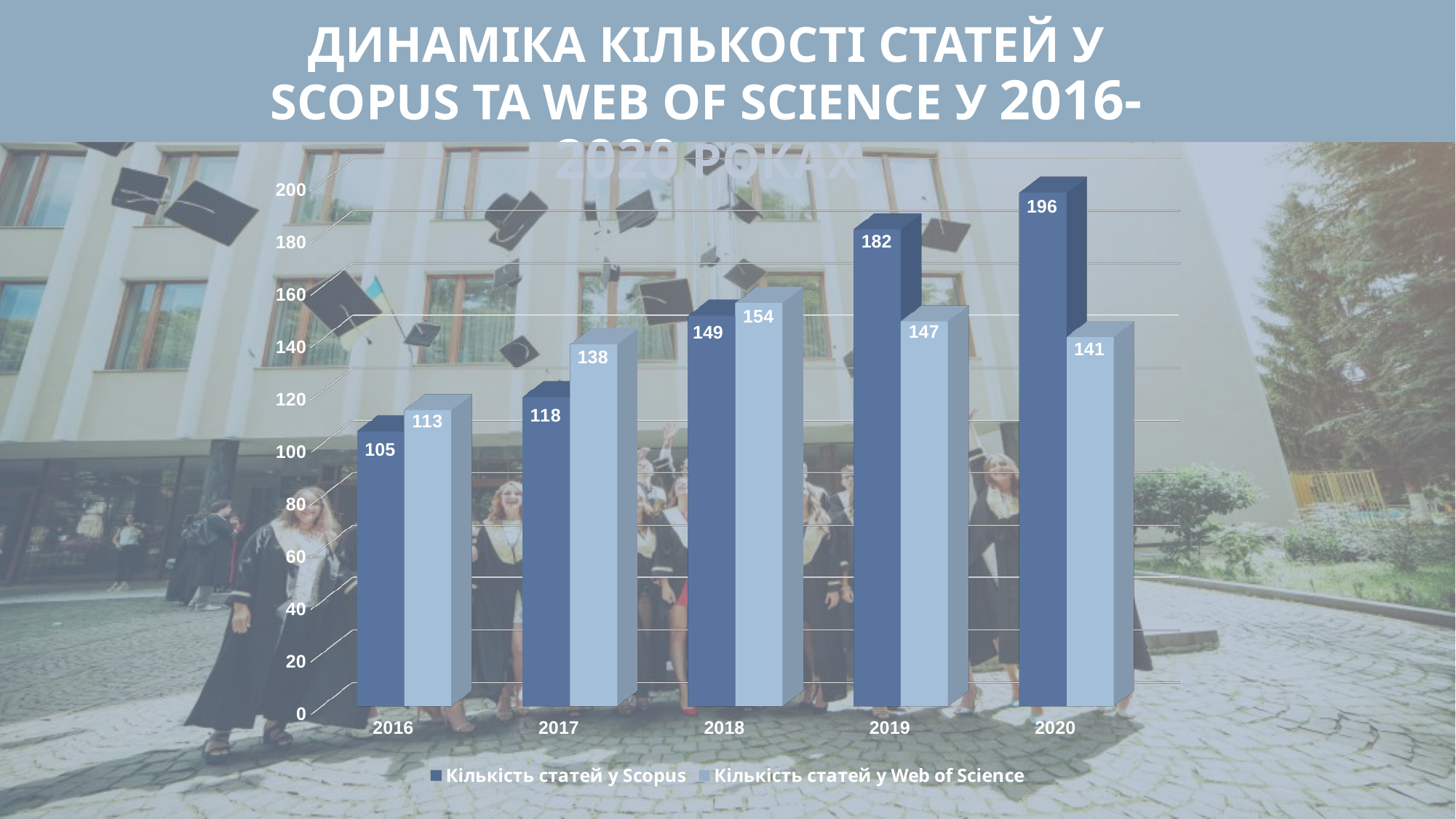
What is the difference between the Scopus and Web of Science article counts in 2020? 55 What is the number of articles in Scopus in 2018? 149 How many series does the legend list? 2 How many years are shown on the x axis? 5 In 2017, which is larger: the number of articles in Scopus or in Web of Science? Web of Science What kind of chart is shown on the slide? Bar chart In which year is the number of articles in Web of Science the lowest? 2016 Which series is shown in the darker blue colour? Кількість статей у Scopus What is the number of articles in Web of Science in 2019? 147 Does the number of articles in Scopus rise or fall from 2016 to 2020? Rise In which year is the number of articles in Scopus the highest? 2020 What is the number of articles in Web of Science in 2017? 138